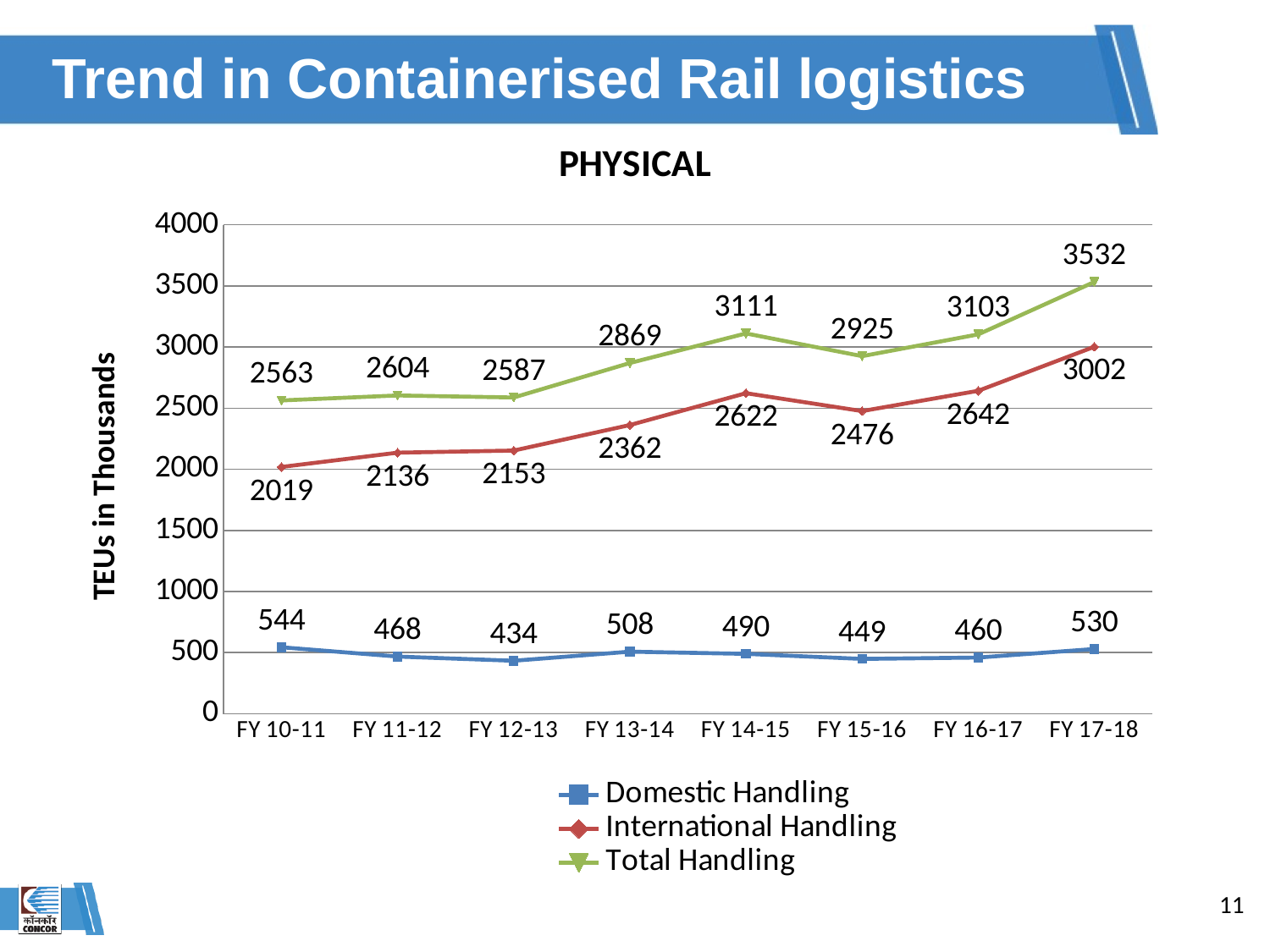
How many fiscal years are shown on the x axis? 8 What is the International Handling value for FY 10-11? 2019 What is the difference between Total Handling in FY 17-18 and FY 16-17? 429 What is the Total Handling value for FY 17-18? 3532 In which fiscal year is Domestic Handling highest? FY 10-11 Which is larger: International Handling in FY 14-15 or in FY 15-16? FY 14-15 In which fiscal year is International Handling lowest? FY 10-11 What kind of chart is shown? line chart What is the y-axis label of the chart? TEUs in Thousands How many series does the legend list? 3 Is the Total Handling value for FY 14-15 greater or less than 3000? greater What is the Domestic Handling value for FY 12-13? 434